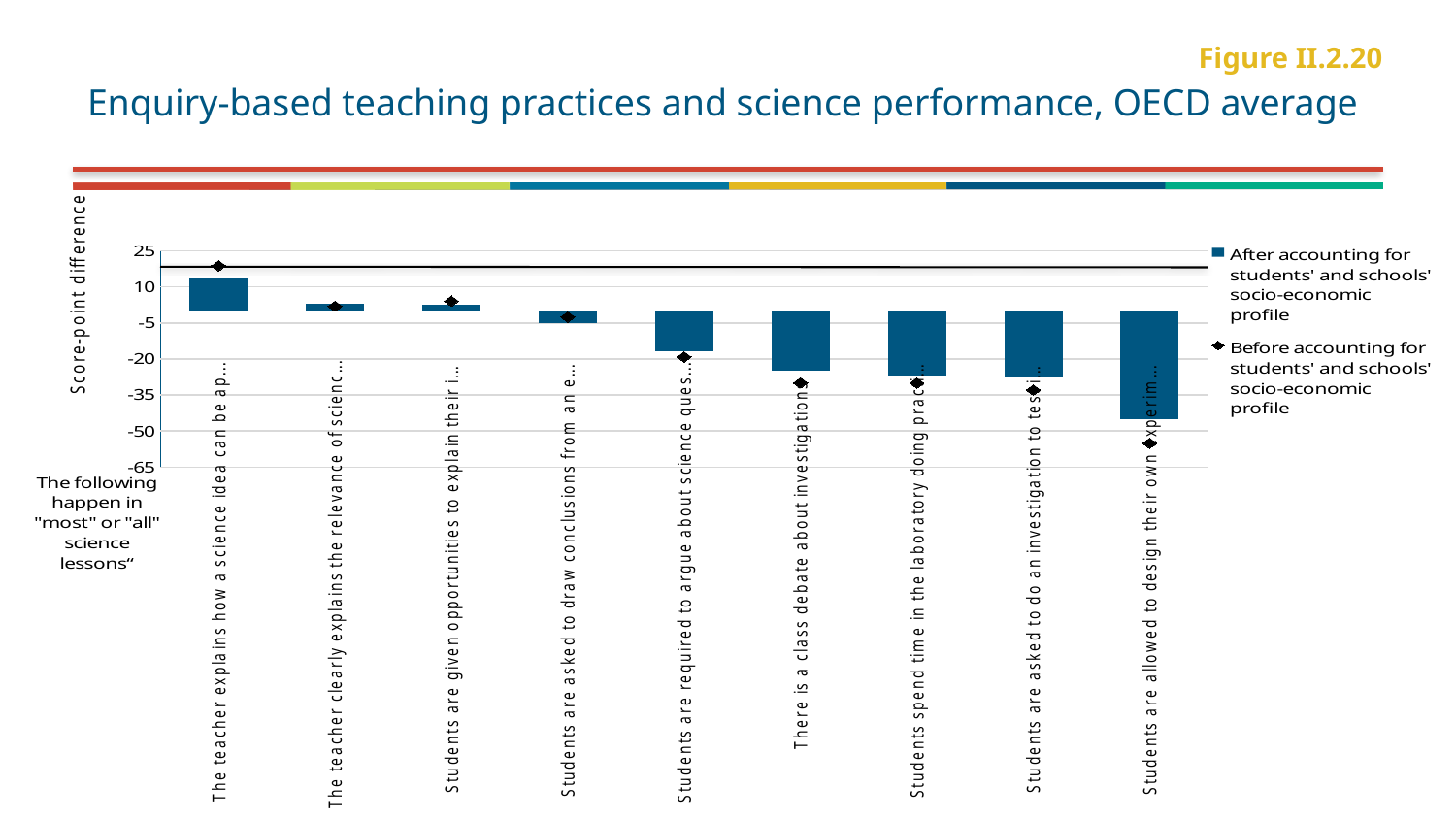
Is the 'After accounting' bar for 'The teacher explains how a science idea can be ap...' greater or less than -5? greater Do the bar values rise or fall moving from left to right along the x axis? fall What kind of chart is shown on the slide? bar chart How many teaching practices (categories) are plotted along the x axis? 9 Which category has the highest score-point difference after accounting for students' and schools' socio-economic profile? The teacher explains how a science idea can be ap... How many series does the legend list? 2 What is the title of the chart? Enquiry-based teaching practices and science performance, OECD average Which category has the lowest score-point difference after accounting for students' and schools' socio-economic profile? Students are allowed to design their own experim... Is the 'After accounting' bar for 'Students are allowed to design their own experim...' greater or less than -35? less Which is larger: the 'After accounting' bar for 'There is a class debate about investigation...' or for 'Students are asked to draw conclusions from an e...'? Students are asked to draw conclusions from an e... Is the 'Before accounting' diamond for 'The teacher explains how a science idea can be ap...' greater or less than 10? greater